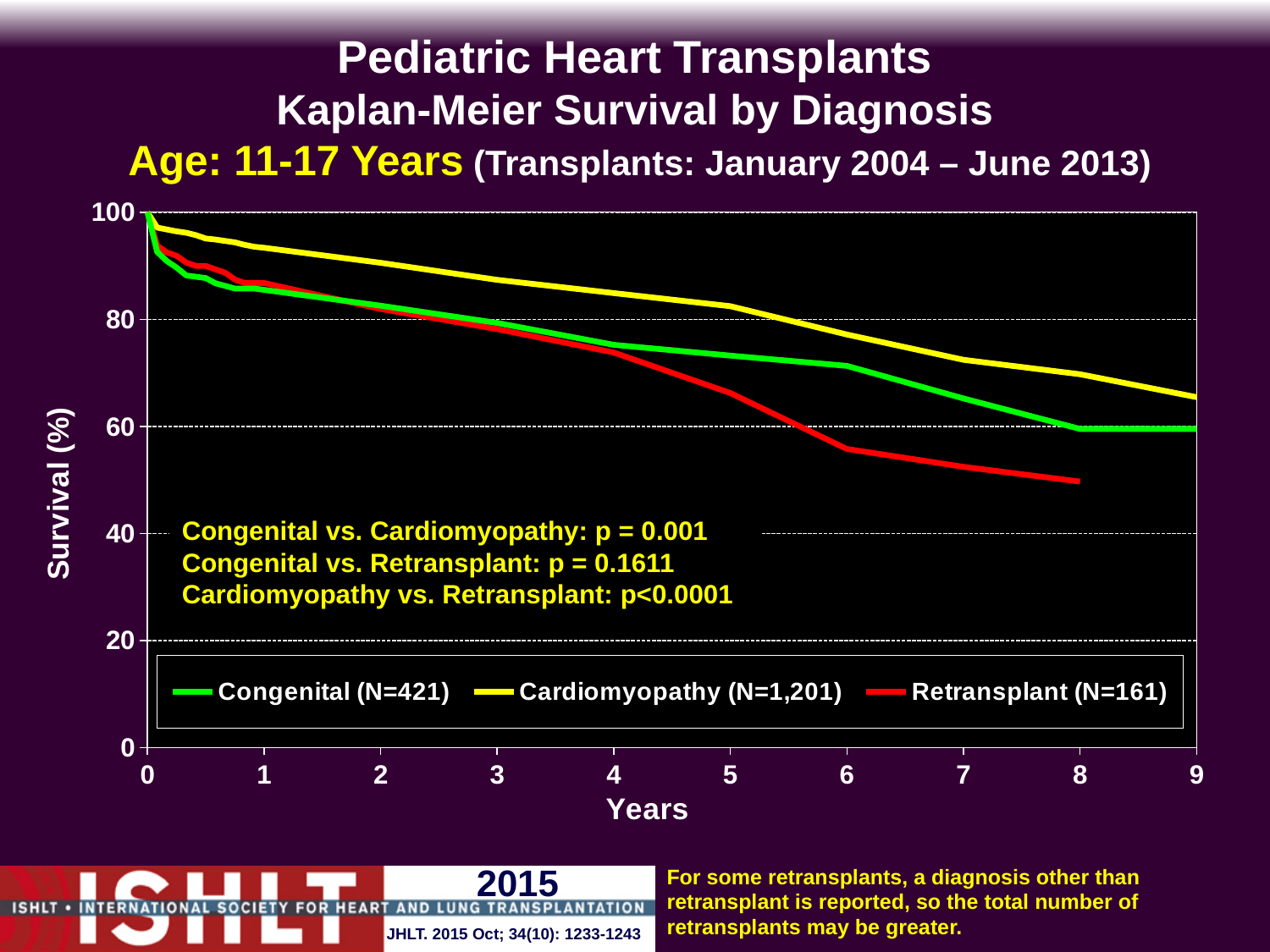
What is the N reported in the legend for the Cardiomyopathy group? 1,201 Which diagnosis group has the lowest survival at year 8? Retransplant Do the survival curves rise or fall as years increase? fall At year 8, which group has higher survival, Cardiomyopathy or Congenital? Cardiomyopathy What kind of chart is shown on the slide? line chart At year 7, which group has higher survival, Congenital or Retransplant? Congenital Is the survival for Congenital at year 6 greater or less than 80? less Which diagnosis group has the highest survival curve across the whole follow-up period? Cardiomyopathy Is the survival for Cardiomyopathy at year 5 greater or less than 80? greater What p-value is shown for Congenital vs. Cardiomyopathy? p = 0.001 Is the survival for Retransplant at year 8 greater or less than 60? less How many series does the legend list? 3